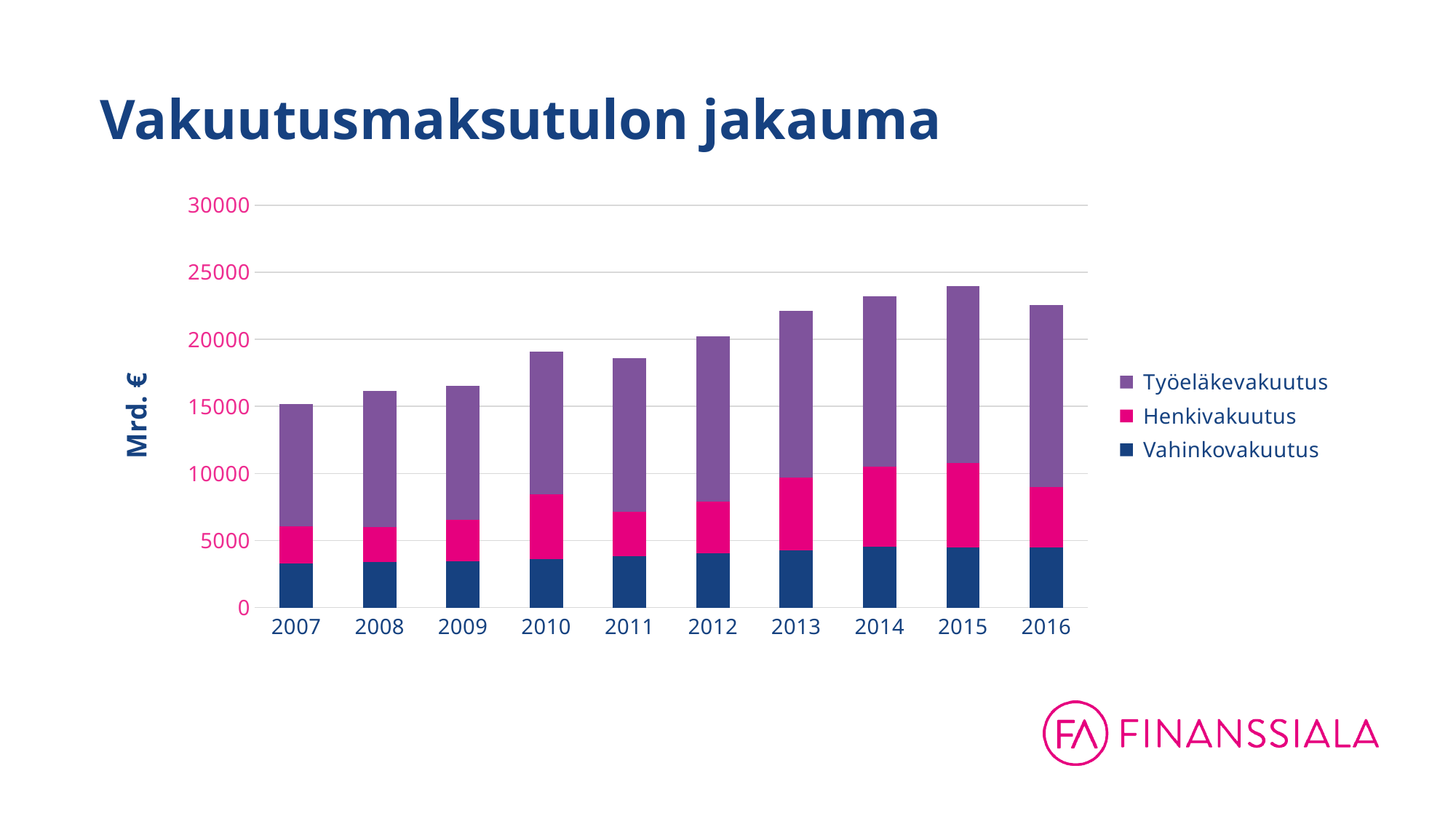
What kind of chart is shown on the slide? Stacked bar chart Is the total bar for 2013 greater or less than 20000? greater What is the title of the chart? Vakuutusmaksutulon jakauma How many years are shown on the x axis? 10 Which year has the lowest total bar? 2007 Do the total bars generally rise or fall from 2007 to 2015? rise Is the total bar for 2007 greater or less than 20000? less Is the Vahinkovakuutus segment for 2016 greater or less than 5000? less What is the label on the y axis? Mrd. € How many series does the legend list? 3 Is the total bar for 2015 larger or smaller than the total bar for 2007? larger Which year has the highest total bar? 2015